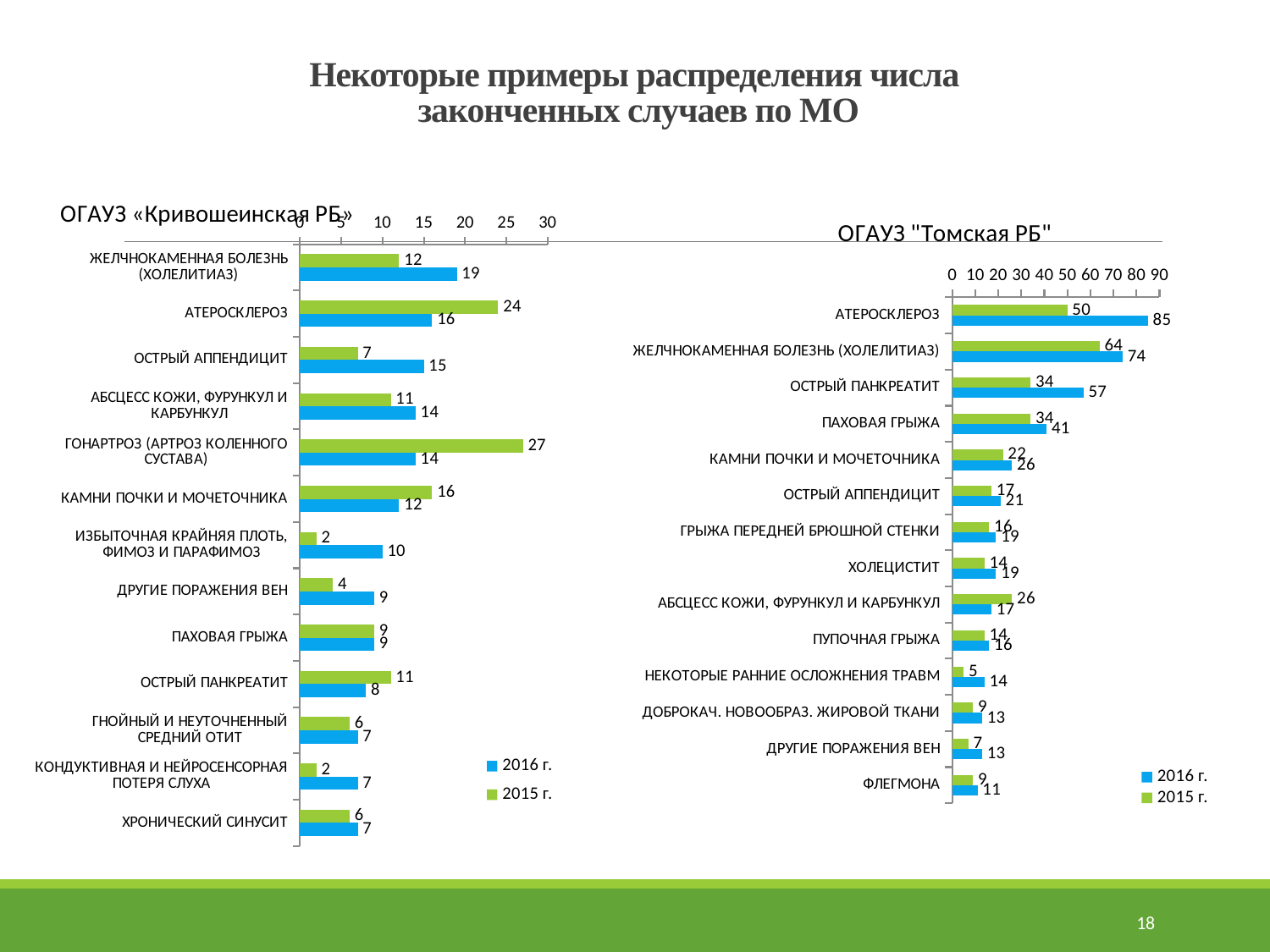
In the ОГАУЗ "Томская РБ" chart, which is larger for АБСЦЕСС КОЖИ, ФУРУНКУЛ И КАРБУНКУЛ: the 2015 г. value or the 2016 г. value? 2015 г. How many series does the legend of the ОГАУЗ "Томская РБ" chart list? 2 In the ОГАУЗ "Томская РБ" chart, what is the difference between the 2016 г. and 2015 г. values for ЖЕЛЧНОКАМЕННАЯ БОЛЕЗНЬ (ХОЛЕЛИТИАЗ)? 10 In the ОГАУЗ «Кривошеинская РБ» chart, what is the 2016 г. value for ЖЕЛЧНОКАМЕННАЯ БОЛЕЗНЬ (ХОЛЕЛИТИАЗ)? 19 In the ОГАУЗ "Томская РБ" chart, which category has the lowest 2015 г. value? НЕКОТОРЫЕ РАННИЕ ОСЛОЖНЕНИЯ ТРАВМ What type of chart is the ОГАУЗ «Кривошеинская РБ» chart? Bar chart In the ОГАУЗ "Томская РБ" chart, what is the 2016 г. value for АТЕРОСКЛЕРОЗ? 85 In the ОГАУЗ «Кривошеинская РБ» chart, what is the difference between the 2015 г. and 2016 г. values for АТЕРОСКЛЕРОЗ? 8 In the ОГАУЗ "Томская РБ" chart, what is the 2015 г. value for ОСТРЫЙ ПАНКРЕАТИТ? 34 In the ОГАУЗ «Кривошеинская РБ» chart, what is the 2015 г. value for ГОНАРТРОЗ (АРТРОЗ КОЛЕННОГО СУСТАВА)? 27 In the ОГАУЗ «Кривошеинская РБ» chart, which category has the highest 2015 г. value? ГОНАРТРОЗ (АРТРОЗ КОЛЕННОГО СУСТАВА) In the ОГАУЗ «Кривошеинская РБ» chart, how many categories are shown? 13